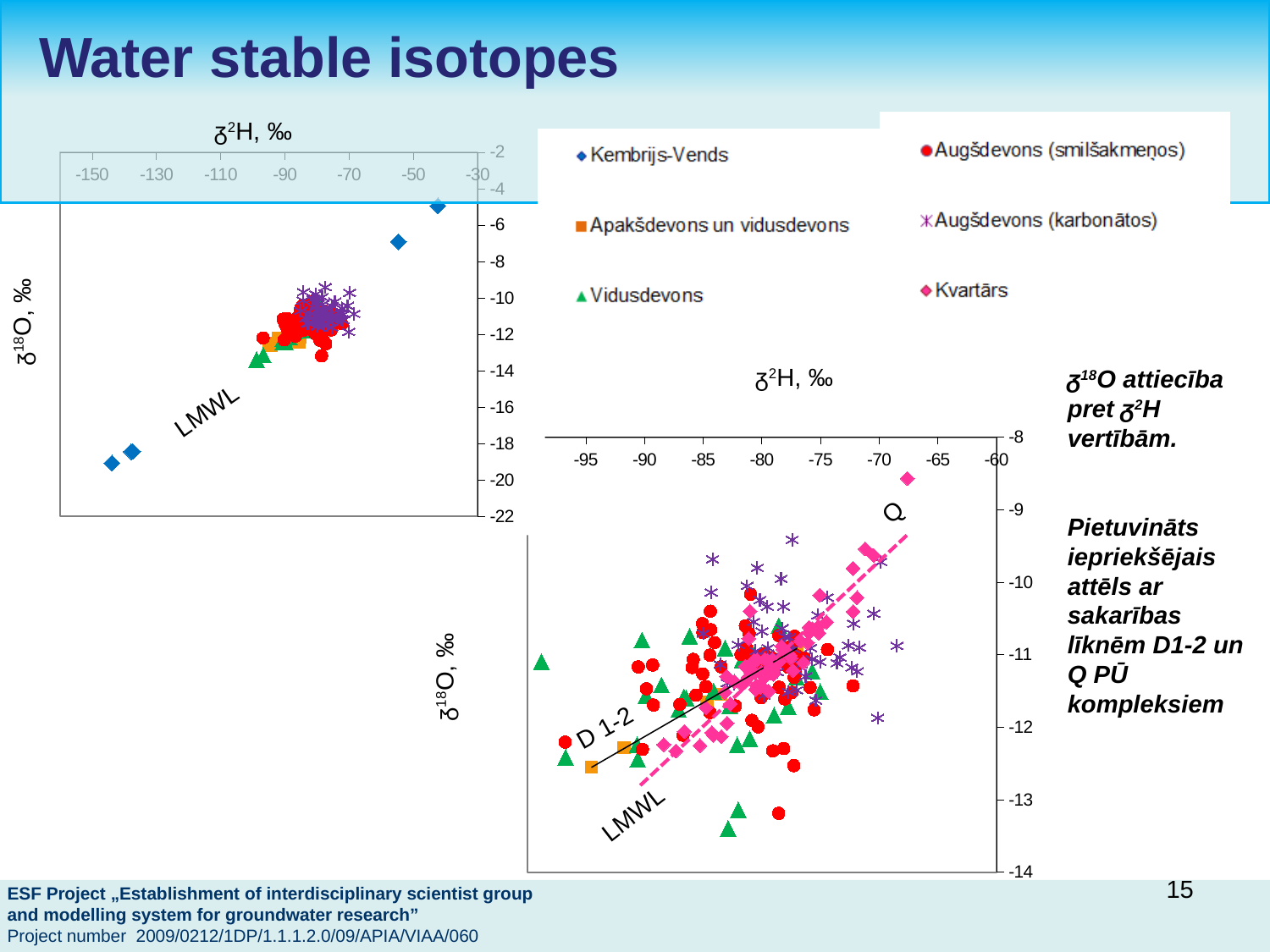
In the left chart, are the δ18O values of the two Kembrijs-Vends points at the lower left greater or less than -18? less What is the lowest δ2H tick shown on the x axis of the left chart? -150 In the bottom-right chart, do the δ18O values generally rise or fall as δ2H increases along the x axis? rise What kind of chart is the chart on the left of the slide? scatter chart What is the lowest δ2H tick shown on the x axis of the bottom-right chart? -95 How many series does the legend list? 6 What is the label of the line drawn through the points in the left chart? LMWL In the left chart, which series has the points with δ2H values below -130? Kembrijs-Vends In the bottom-right chart, is the δ18O value of the highest Kvartārs point (near δ2H -68) greater or less than -9? greater In the bottom-right chart, is the δ18O value of the leftmost Vidusdevons point (near δ2H -97) greater or less than -10? less What are the labels of the two fitted lines in the bottom-right chart besides LMWL? D 1-2 and Q